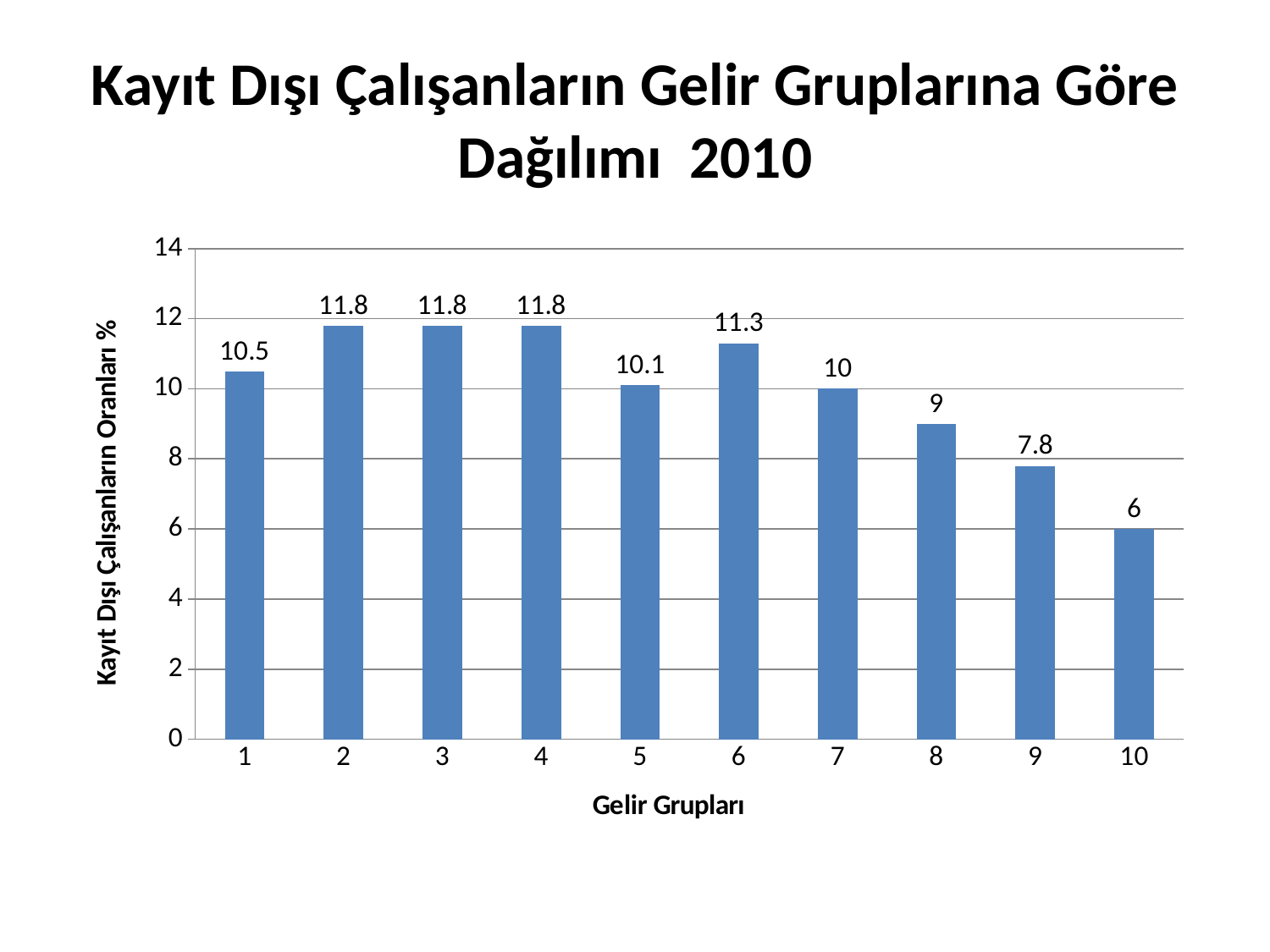
What is the difference between the values for income group 2 and income group 10? 5.8 What kind of chart is shown on the slide? bar chart Is the value for income group 8 greater or less than 10? less What is the difference between the values for income group 7 and income group 8? 1 What is the value for income group 1? 10.5 How many income groups are shown on the x axis? 10 Do the values generally rise or fall from income group 6 to income group 10? fall What is the value for income group 6? 11.3 Which income group has the lowest value? 10 What is the label of the x axis? Gelir Grupları Which is larger, the value for income group 5 or income group 6? income group 6 What is the value for income group 9? 7.8